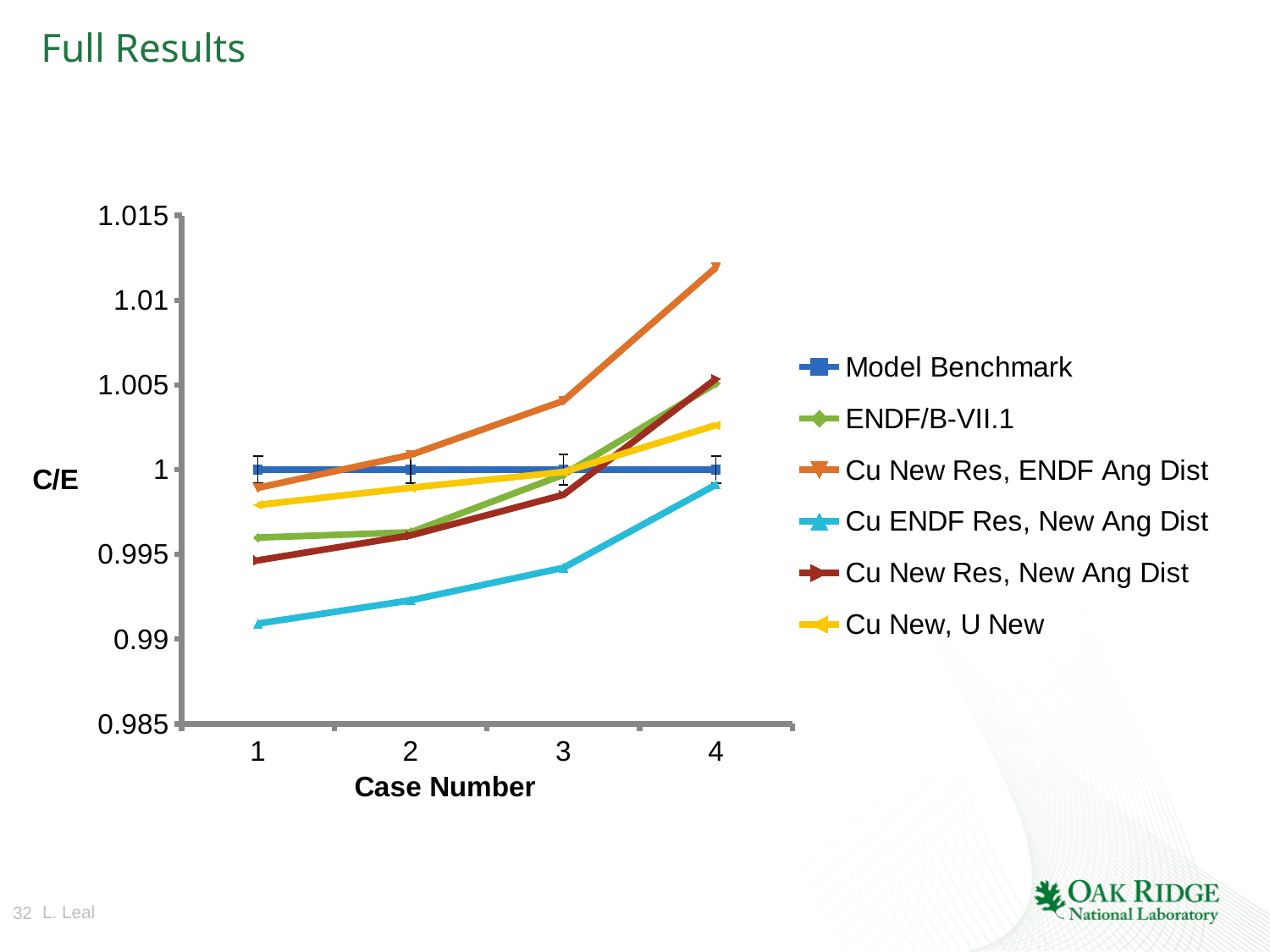
Does the C/E value for Cu New Res, ENDF Ang Dist rise or fall from case number 1 to case number 4? rise How many case numbers are plotted along the x axis? 4 At case number 4, which series has the larger C/E value: Cu New Res, ENDF Ang Dist or Cu ENDF Res, New Ang Dist? Cu New Res, ENDF Ang Dist What is the C/E value of the Model Benchmark series at case number 1? 1 What kind of chart is shown on the slide? line chart How many series does the legend list? 6 Is the C/E value for Cu New, U New at case number 1 greater or less than 1? less Is the C/E value for Cu New Res, ENDF Ang Dist at case number 4 greater or less than 1.01? greater Which series has the highest C/E value at case number 4? Cu New Res, ENDF Ang Dist What is the title of the x axis? Case Number Is the C/E value for Cu ENDF Res, New Ang Dist at case number 1 greater or less than 0.995? less Which series has the lowest C/E value at case number 1? Cu ENDF Res, New Ang Dist